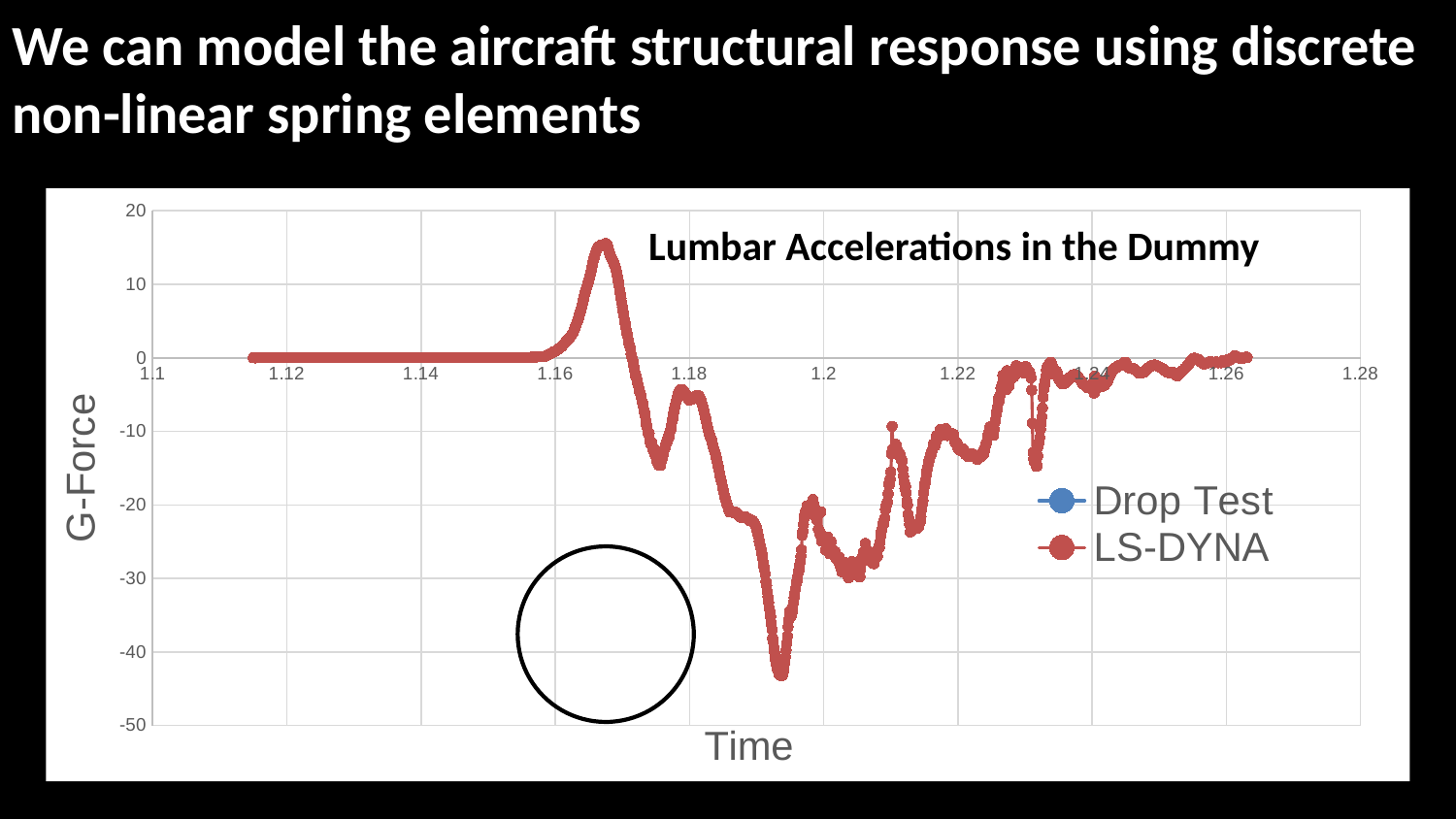
Is the lowest G-Force value reached by the LS-DYNA series greater or less than -40? less What kind of chart is shown on the slide? line chart Does the LS-DYNA series rise or fall between time 1.22 and time 1.26? rise How many series does the legend list? 2 Is the G-Force value of the LS-DYNA series at time 1.26 greater or less than -10? greater Is the G-Force value of the LS-DYNA series at time 1.2 greater or less than -10? less Does the LS-DYNA series rise or fall between time 1.16 and its peak just before 1.18? rise What is the title of the chart? Lumbar Accelerations in the Dummy What are the two series named in the legend? Drop Test and LS-DYNA